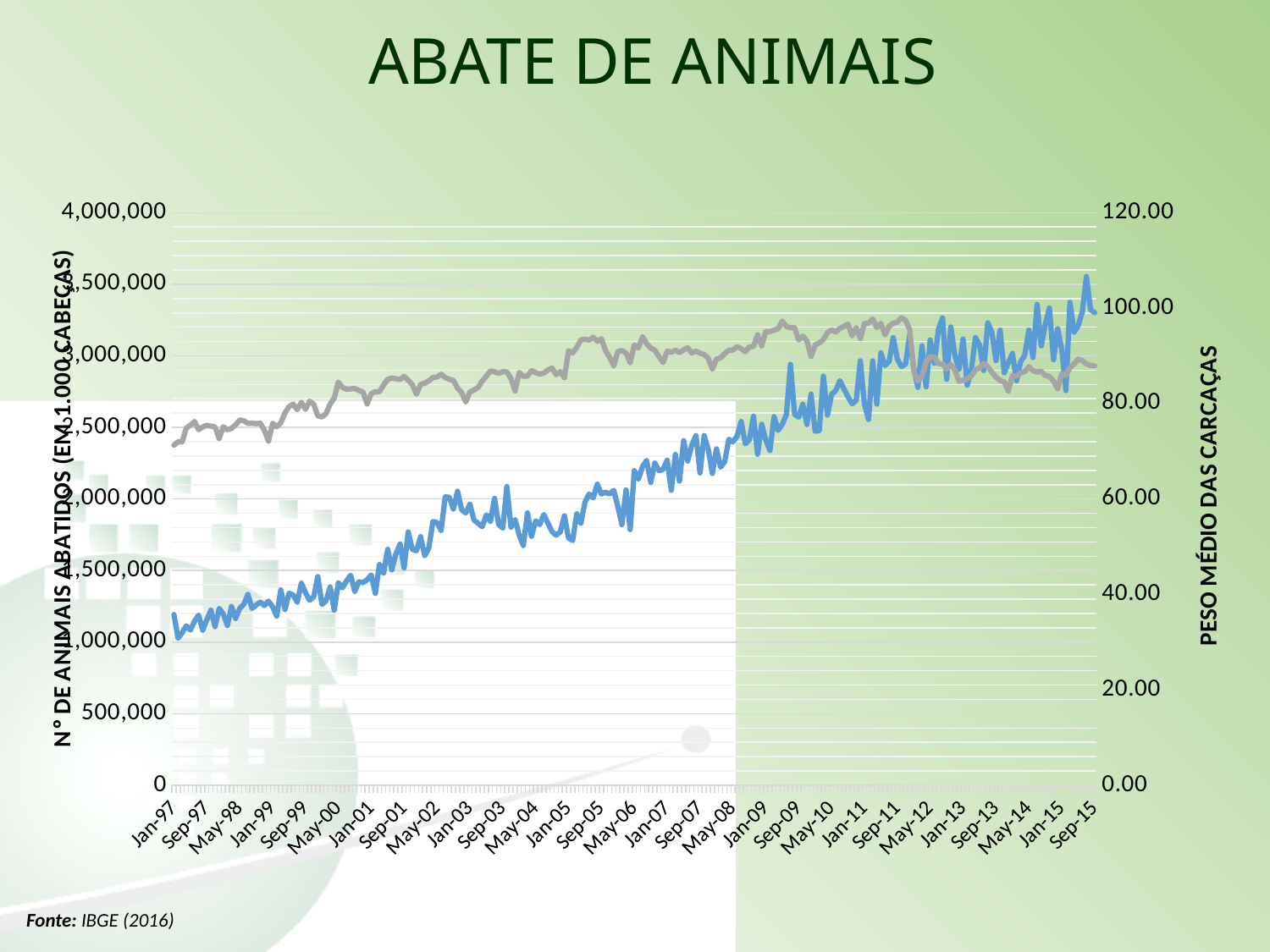
What is the first date label shown on the x axis? Jan-97 What is the label of the right-hand vertical axis? PESO MÉDIO DAS CARCAÇAS What is the title of the chart? ABATE DE ANIMAIS Is the value of the blue line at Jan-97 greater or less than 1,500,000? less Is the value of the gray line at Sep-15 greater or less than 100.00 on the right axis? less Is the value of the blue line at Sep-15 greater or less than 3,000,000? greater What kind of chart is shown on the slide? Line chart Does the blue line (number of animals slaughtered) generally rise or fall from Jan-97 to Sep-15? Rise Which line is higher relative to its own axis at Jan-97: the blue line (left axis, max 4,000,000) or the gray line (right axis, max 120.00)? Gray line How many lines (data series) are plotted on the chart? 2